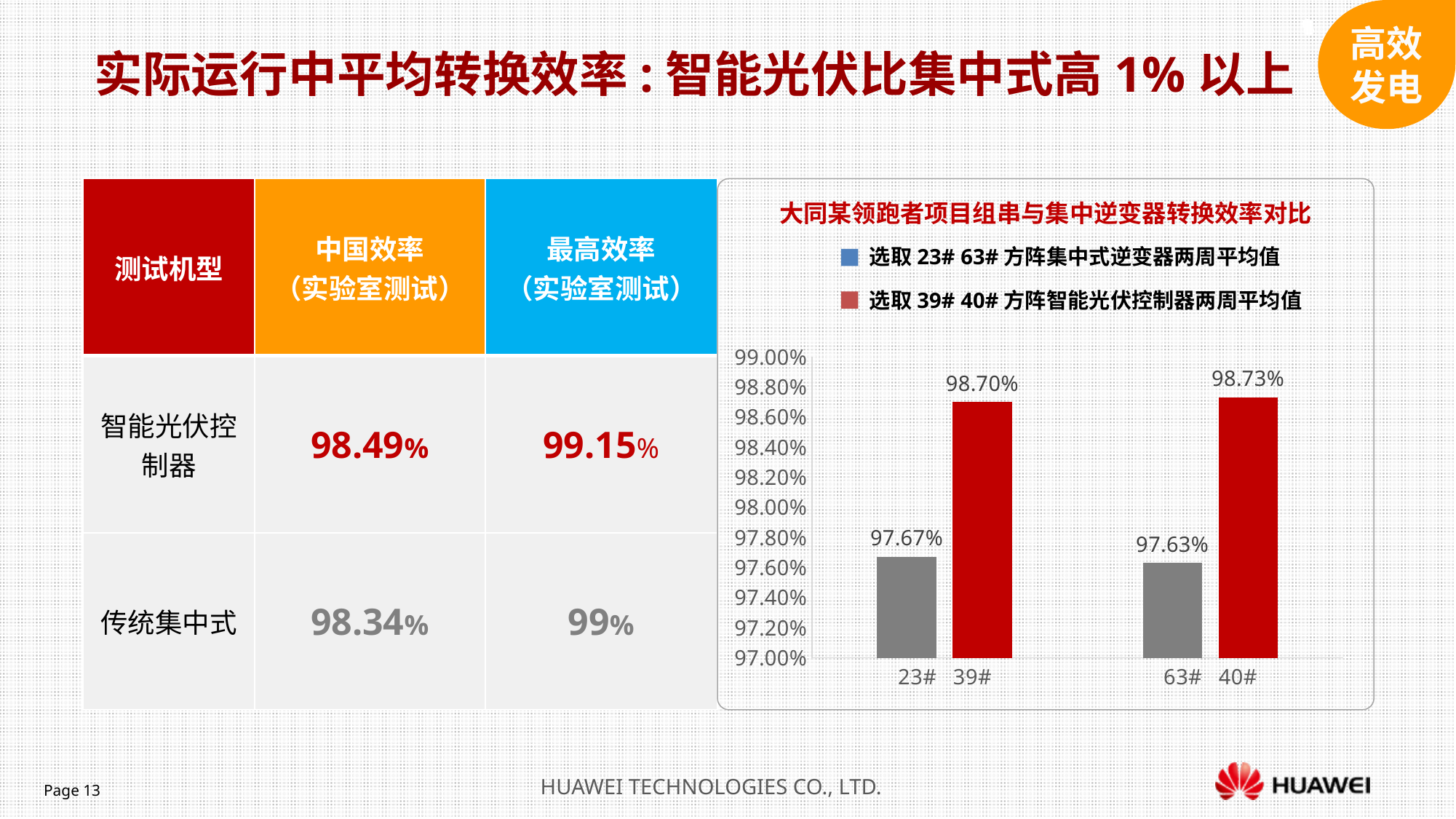
Which category has the lowest value in the chart? 63# What is the difference between the values for 39# and 23#? 1.03% Which category has the highest value in the chart? 40# What is the value for 23# in the chart? 97.67% What is the value for 40# in the chart? 98.73% What is the value for 39# in the chart? 98.70% What is the difference between the values for 40# and 63#? 1.10% How many bars are shown in the chart? 4 Is the value for 23# greater or less than 98.00%? less How many series does the chart legend list? 2 What is the value for 63# in the chart? 97.63% Which is larger, the value for 39# or the value for 23#? 39#